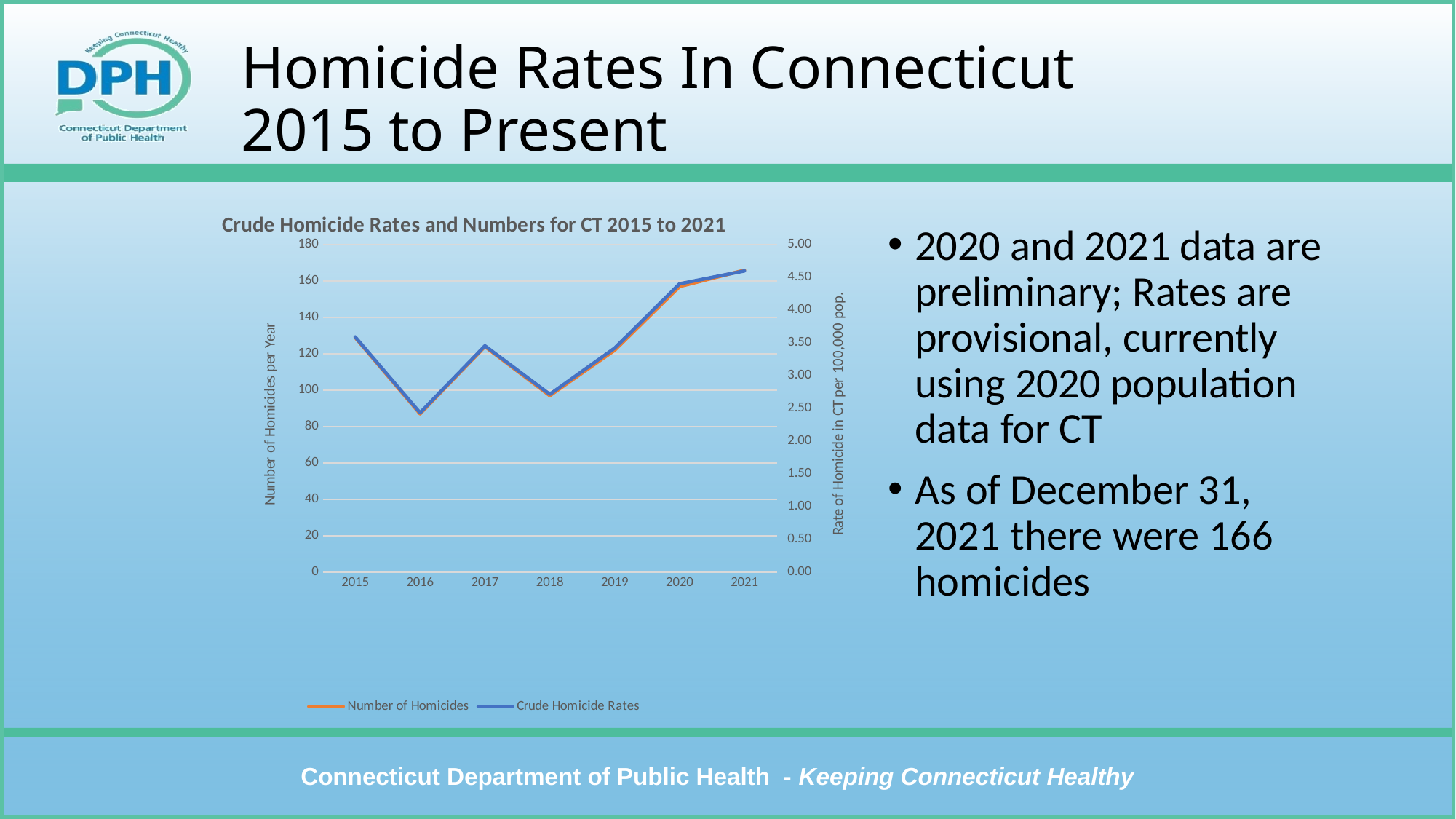
In which year is the number of homicides highest? 2021 How many years are plotted along the x axis of the chart? 7 What kind of chart is shown on the slide? line chart In which year is the number of homicides lowest? 2016 What is the title of the chart? Crude Homicide Rates and Numbers for CT 2015 to 2021 How many series does the chart legend list? 2 Which year has more homicides, 2015 or 2016? 2015 Is the number of homicides in 2020 greater or less than 140? greater Is the number of homicides in 2015 greater or less than 120? greater Is the number of homicides in 2016 greater or less than 100? less Do the number of homicides rise or fall from 2018 to 2021? rise Which year has more homicides, 2019 or 2020? 2020